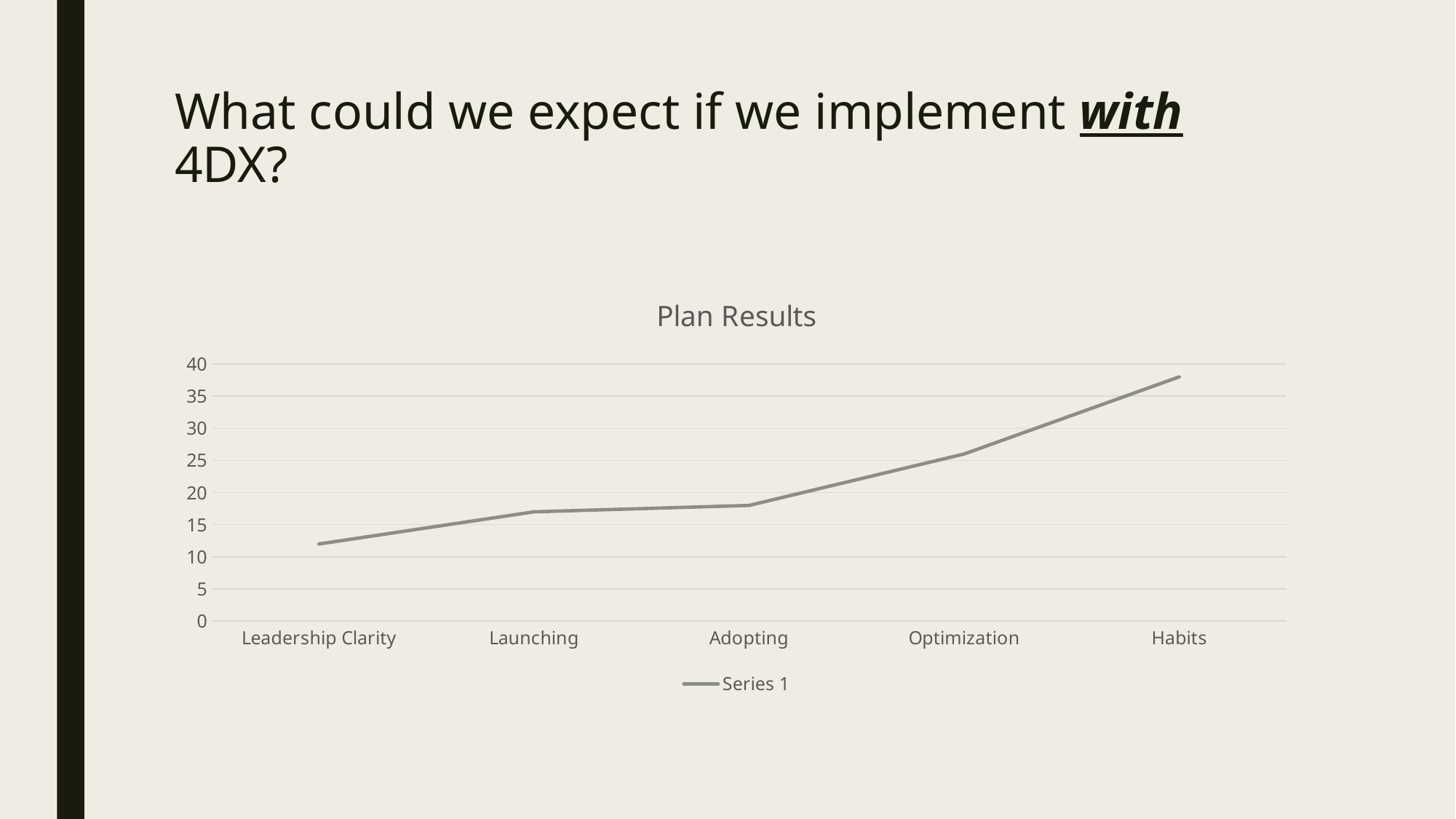
How many categories are shown along the x axis of the chart? 5 Is the value for Optimization greater or less than 30? less Do the values rise or fall from Leadership Clarity to Habits? rise Which category has the highest value? Habits Which category has the lowest value? Leadership Clarity What kind of chart is shown on the slide? line chart Is the value for Leadership Clarity greater or less than 15? less Which is larger, the value for Optimization or the value for Launching? Optimization What is the title of the chart? Plan Results How many series does the chart's legend list? 1 What is the name of the series shown in the legend? Series 1 Is the value for Habits greater or less than 35? greater